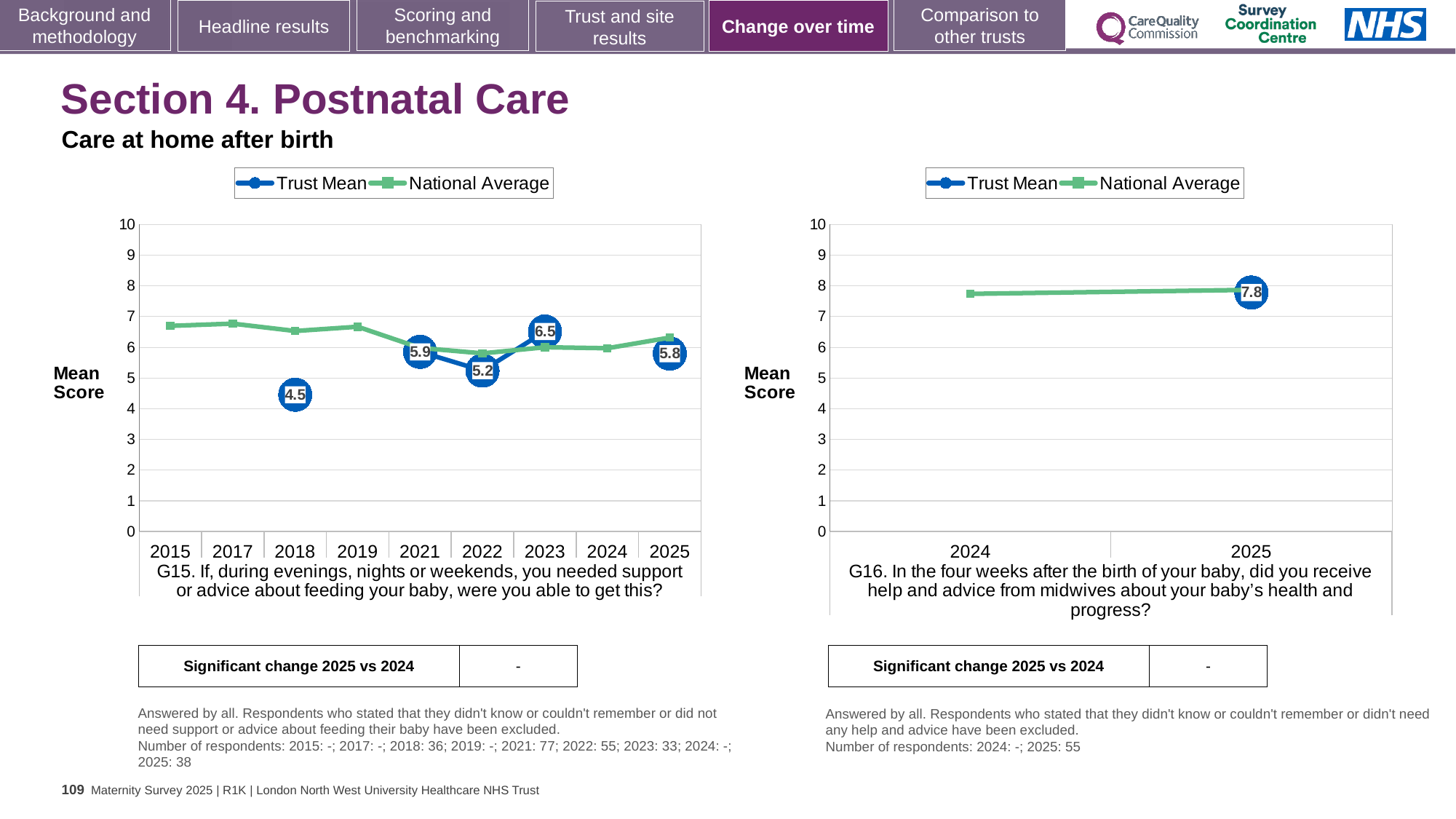
On the G16 chart (right), how many series does the legend list? 2 On the G15 chart (left), what is the Trust Mean for 2018? 4.5 On the G15 chart (left), is the Trust Mean higher in 2021 or in 2022? 2021 On the G15 chart (left), what is the Trust Mean for 2023? 6.5 On the G15 chart (left), what is the Trust Mean for 2025? 5.8 On the G16 chart (right), what is the Trust Mean for 2025? 7.8 On the G15 chart (left), how many years are shown on the x axis? 9 On the G15 chart (left), which year has the highest labelled Trust Mean? 2023 On the G15 chart (left), is the National Average for 2015 greater or less than 6? greater On the G15 chart (left), which year has the lowest labelled Trust Mean? 2018 On the G15 chart (left), what is the difference between the Trust Mean in 2023 and in 2022? 1.3 What type of chart is the G16 chart (right)? Line chart